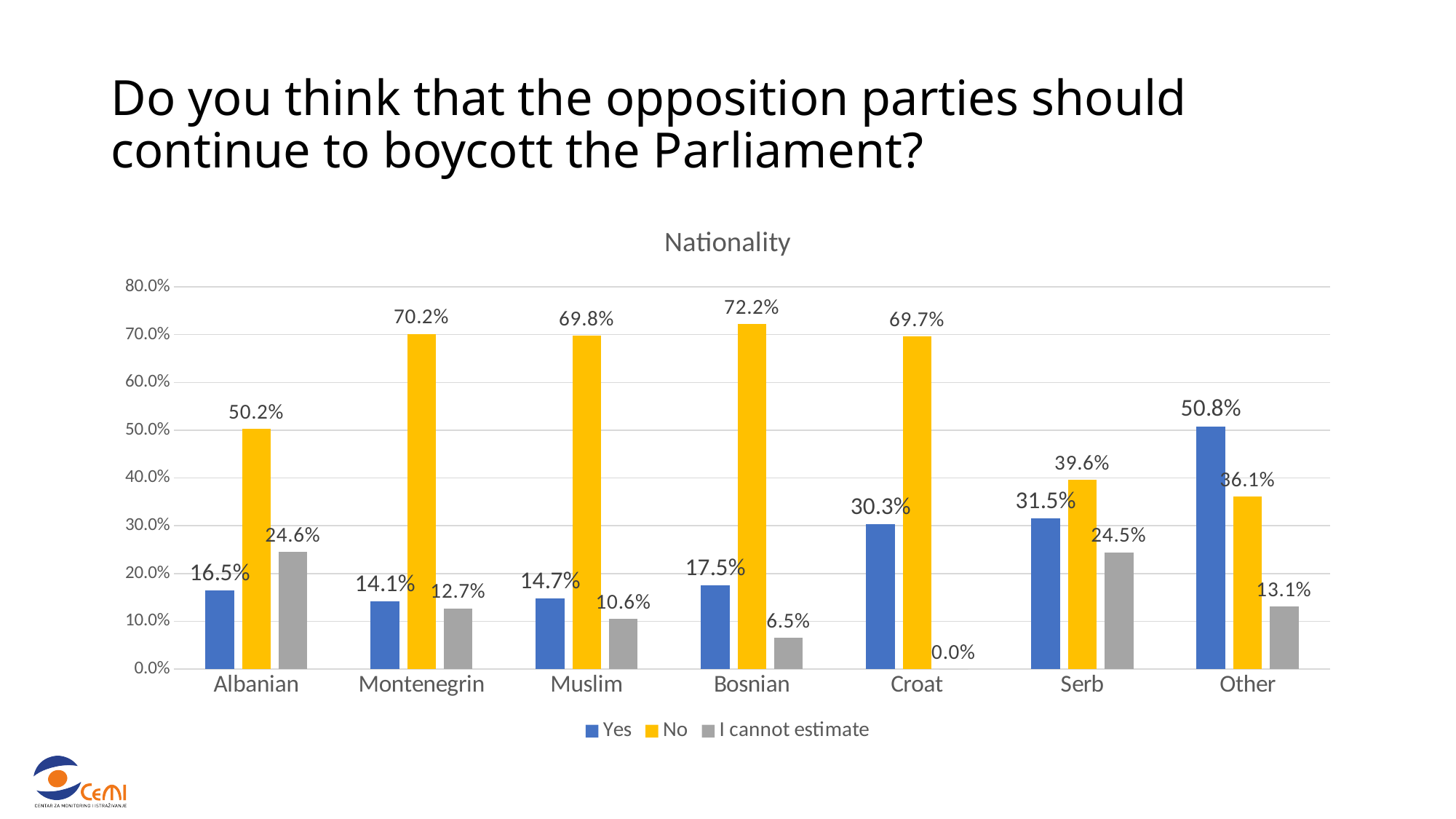
Which nationality has the highest 'No' value? Bosnian Which is larger for Albanian: the 'Yes' value or the 'I cannot estimate' value? I cannot estimate What kind of chart is shown on the slide? Bar chart How many series does the legend list? 3 What is the 'Yes' value for Other? 50.8% Which colour represents the 'No' series? Yellow What is the 'I cannot estimate' value for Croat? 0.0% Which nationality has the lowest 'Yes' value? Montenegrin How many nationality categories are shown on the x axis? 7 What is the difference between the 'No' and 'Yes' values for Serb? 8.1% What is the title of the chart? Nationality What is the 'No' value for Bosnian? 72.2%